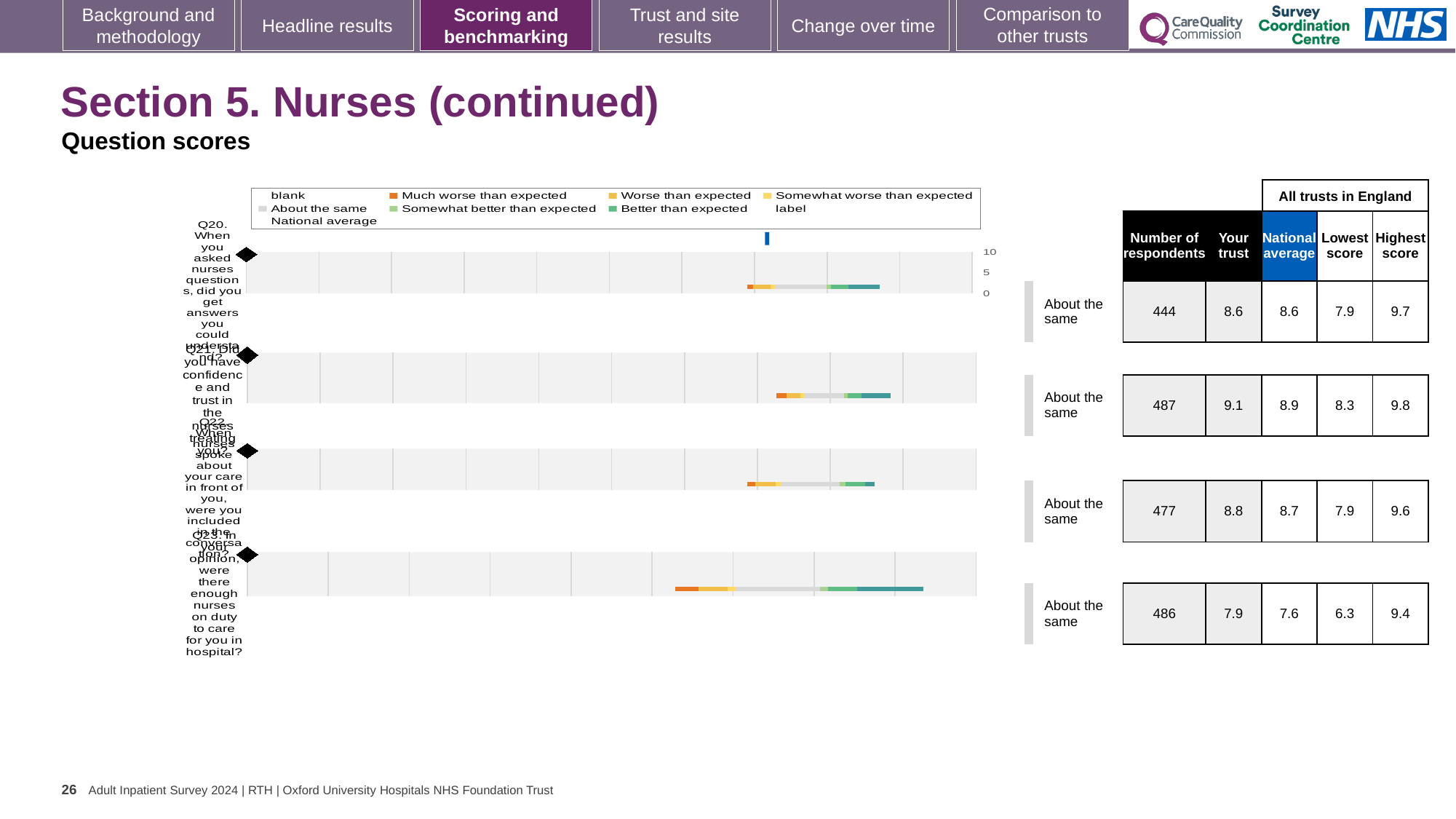
What is the national average score for Q23 (enough nurses on duty)? 7.6 What is the difference between the highest and lowest scores across all trusts for Q23? 3.1 For Q22, which is larger: the 'Your trust' score or the national average? Your trust Which question has the highest 'Your trust' score? Q21 What is the 'Your trust' score for Q21 (confidence and trust in the nurses)? 9.1 What kind of chart is used to show the question scores on this slide? bar chart How many respondents answered Q20? 444 What benchmark category is shown for Q20? About the same Which question has the lowest 'Your trust' score? Q23 What is the difference between the 'Your trust' score and the national average for Q21? 0.2 How many questions (rows) are plotted in the chart? 4 What is the highest score across all trusts in England for Q22? 9.6